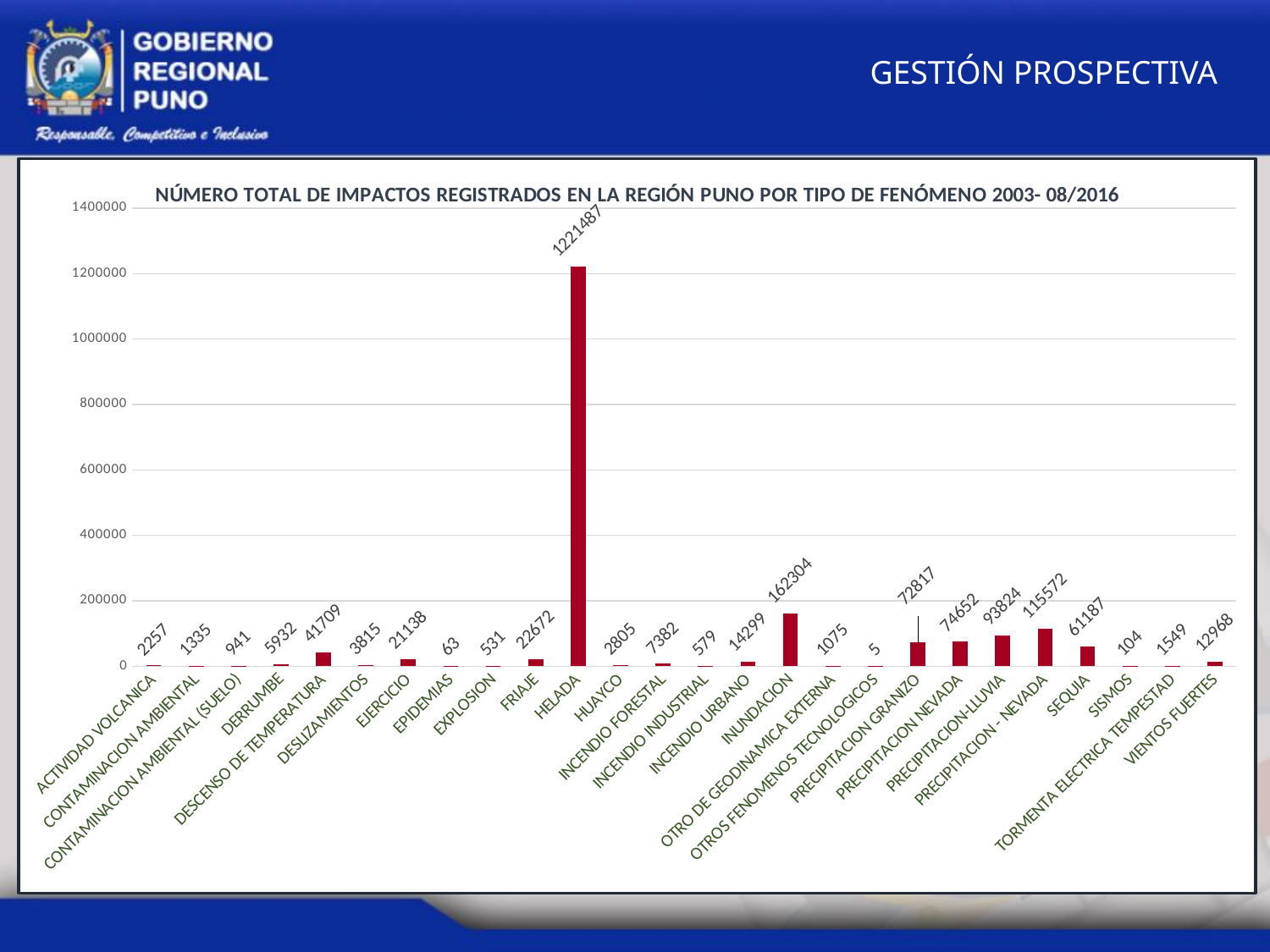
How many types of phenomenon (categories) are shown on the x axis? 26 Which is larger, the value for INUNDACION or the value for PRECIPITACION GRANIZO? INUNDACION What is the title of the chart? NÚMERO TOTAL DE IMPACTOS REGISTRADOS EN LA REGIÓN PUNO POR TIPO DE FENÓMENO 2003- 08/2016 What is the value for HELADA? 1221487 What is the difference between the values for HELADA and INUNDACION? 1059183 What is the value for SEQUIA? 61187 What type of chart is shown on the slide? Bar chart What is the value for DESCENSO DE TEMPERATURA? 41709 What is the difference between the values for PRECIPITACION - NEVADA and PRECIPITACION-LLUVIA? 21748 Which phenomenon has the lowest number of registered impacts? OTROS FENOMENOS TECNOLOGICOS What is the value for INUNDACION? 162304 Which phenomenon has the highest number of registered impacts? HELADA